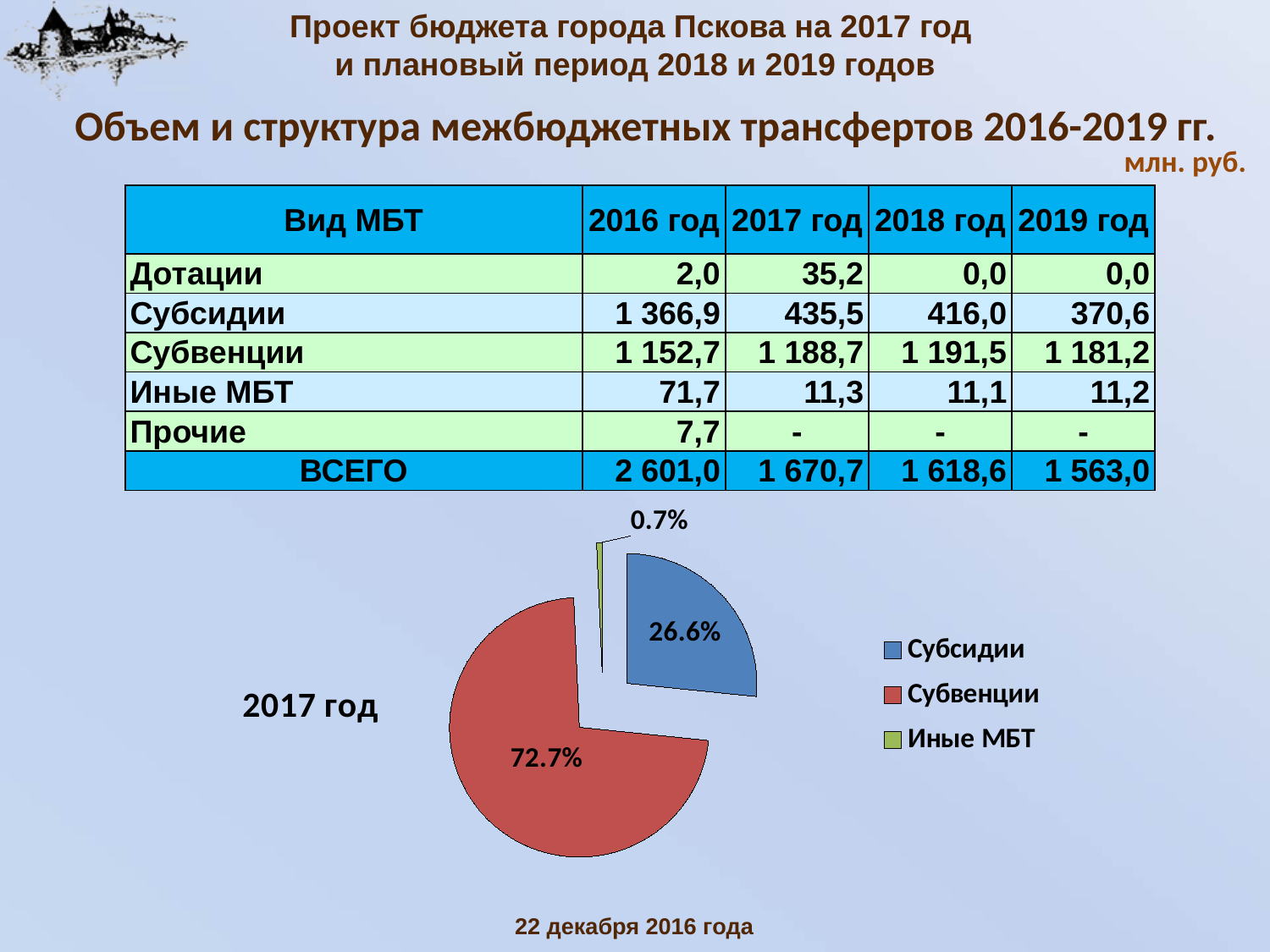
How many slices does the pie chart have? 3 How many entries does the pie chart legend list? 3 What kind of chart is shown on the slide? pie chart Which category has the smallest slice in the pie chart? Иные МБТ What share of the pie chart does Субвенции have? 72.7% Which year does the pie chart represent? 2017 год What colour is the Субвенции slice in the pie chart? red What is the difference in percentage points between the Субвенции and Субсидии slices? 46.1 Which category has the largest slice in the pie chart? Субвенции What share of the pie chart does Субсидии have? 26.6% Which is larger in the pie chart, Субсидии or Субвенции? Субвенции What share of the pie chart does Иные МБТ have? 0.7%